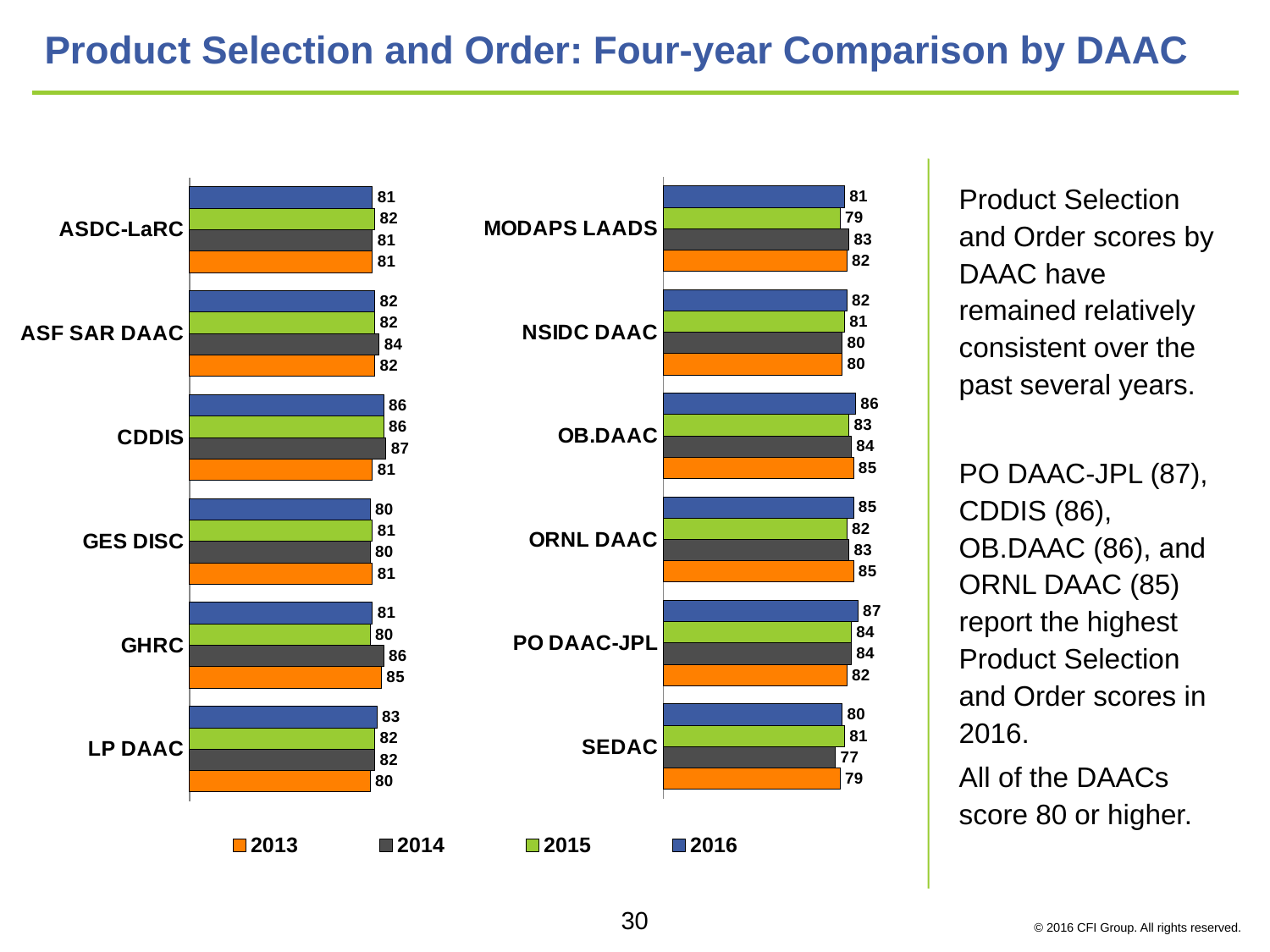
In the right chart, which DAAC has the lowest 2014 value? SEDAC In the left chart, which DAAC has the lowest 2013 value? LP DAAC What type of chart is used on this slide? bar chart In the left chart, what is the 2016 value for CDDIS? 86 How many series does the legend list? 4 In the right chart, what is the 2013 value for SEDAC? 79 In the left chart, what is the difference between the 2014 and 2013 values for CDDIS? 6 In the left chart, what is the 2015 value for GHRC? 80 In the right chart, what is the 2014 value for MODAPS LAADS? 83 In the right chart, which DAAC has the highest 2016 value? PO DAAC-JPL In the right chart, is the 2016 value for OB.DAAC larger or smaller than the 2016 value for NSIDC DAAC? larger How many DAACs are shown in the left chart? 6